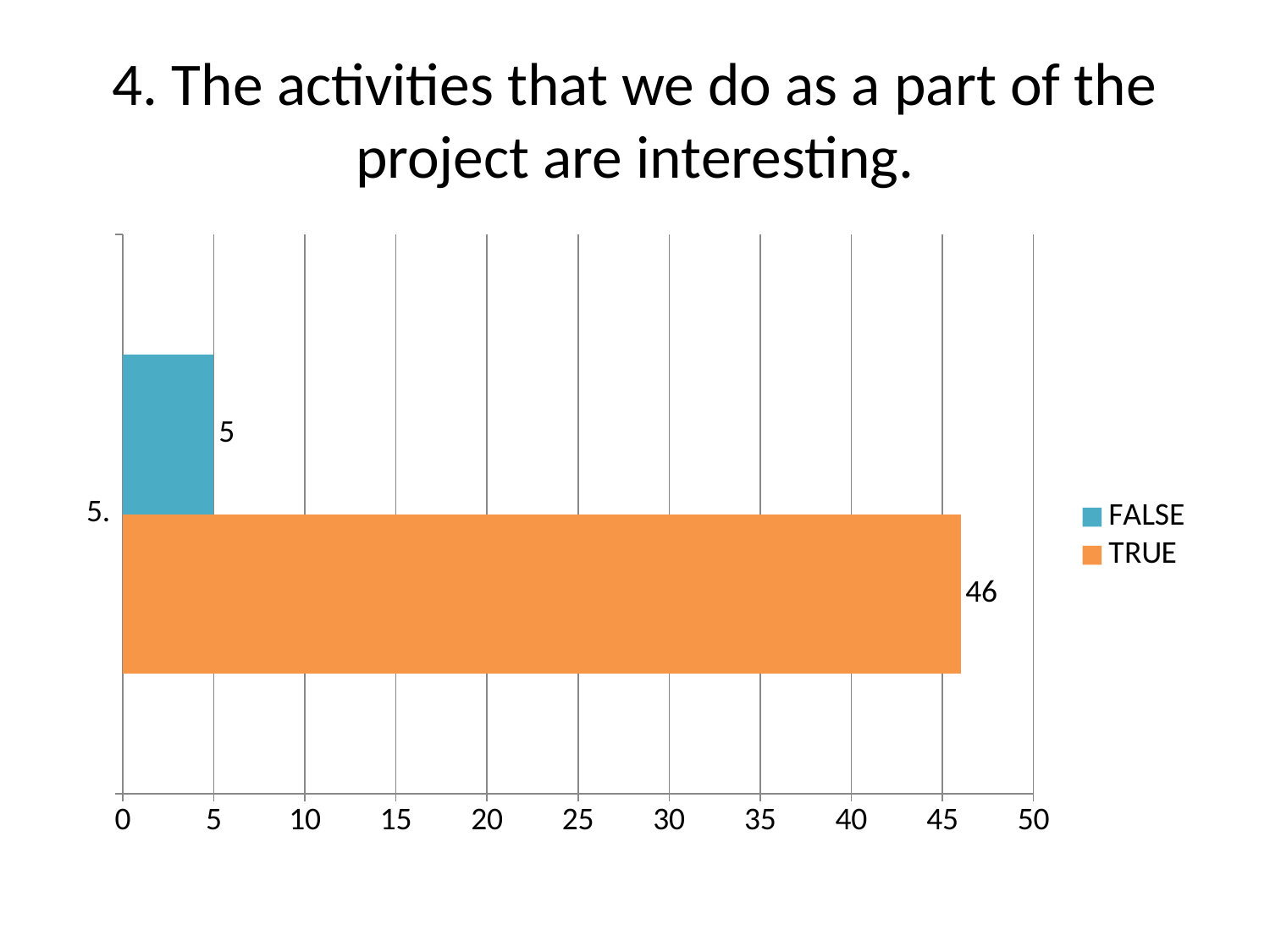
Is the value for FALSE greater or less than 10? less Which series has the lowest value? FALSE What is the total of the TRUE and FALSE values? 51 How many series does the legend list? 2 What colour is the bar for TRUE? orange Is the value for TRUE greater or less than 40? greater What is the difference between the TRUE and FALSE values? 41 Which series has the higher value, TRUE or FALSE? TRUE What is the value for TRUE? 46 What kind of chart is shown on the slide? bar chart What is the maximum value shown on the horizontal axis? 50 What is the value for FALSE? 5